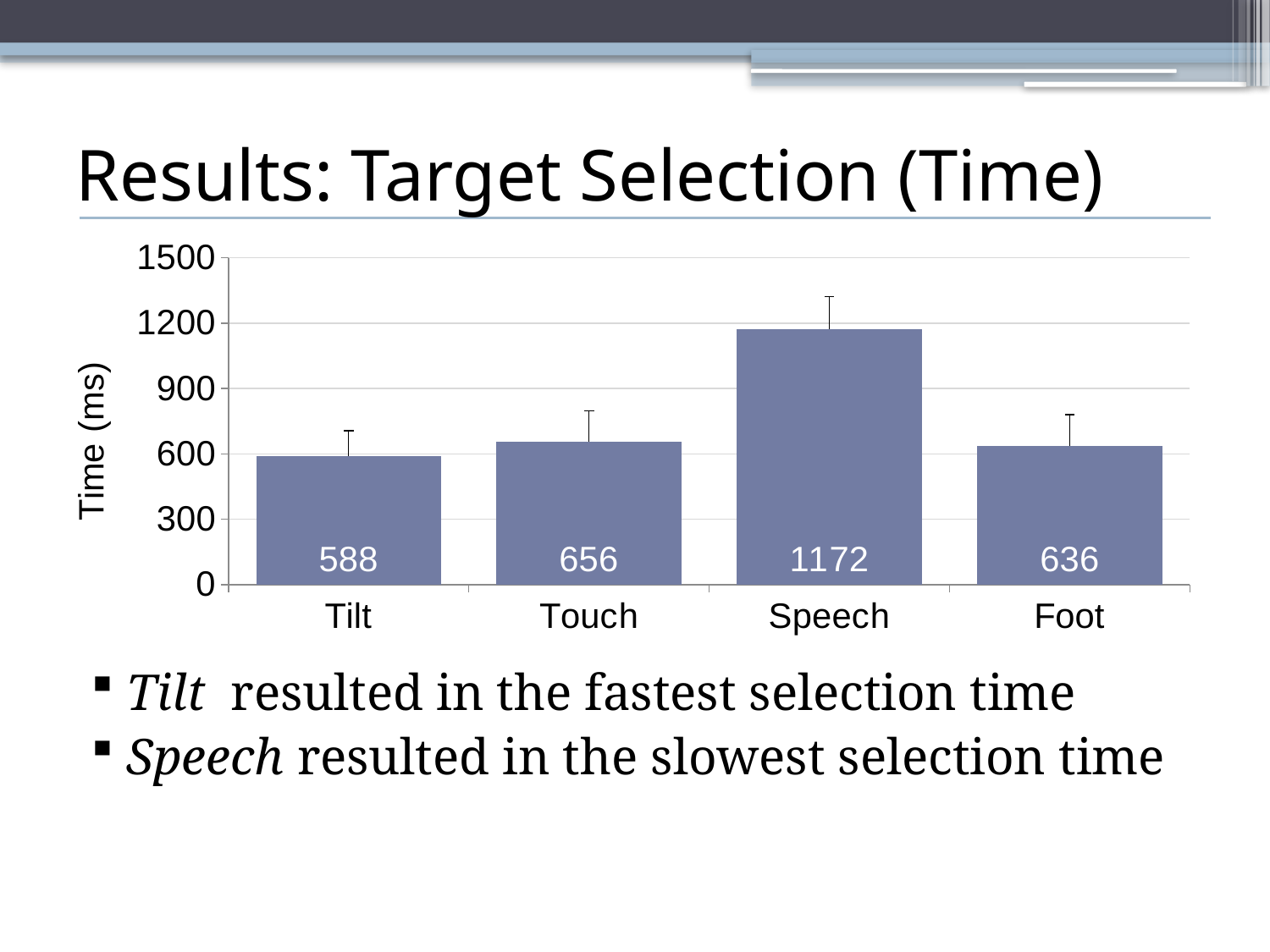
What is the label of the y axis? Time (ms) What is the difference in selection time between Touch and Foot? 20 Which input method has the highest selection time? Speech What is the selection time for Tilt? 588 Is the value for Speech greater or less than 900? greater Which input method has the lowest selection time? Tilt What is the selection time for Speech? 1172 Which has a larger selection time, Touch or Tilt? Touch How many input methods are shown on the chart? 4 What kind of chart is shown on the slide? bar chart What is the difference in selection time between Speech and Tilt? 584 What is the selection time for Foot? 636